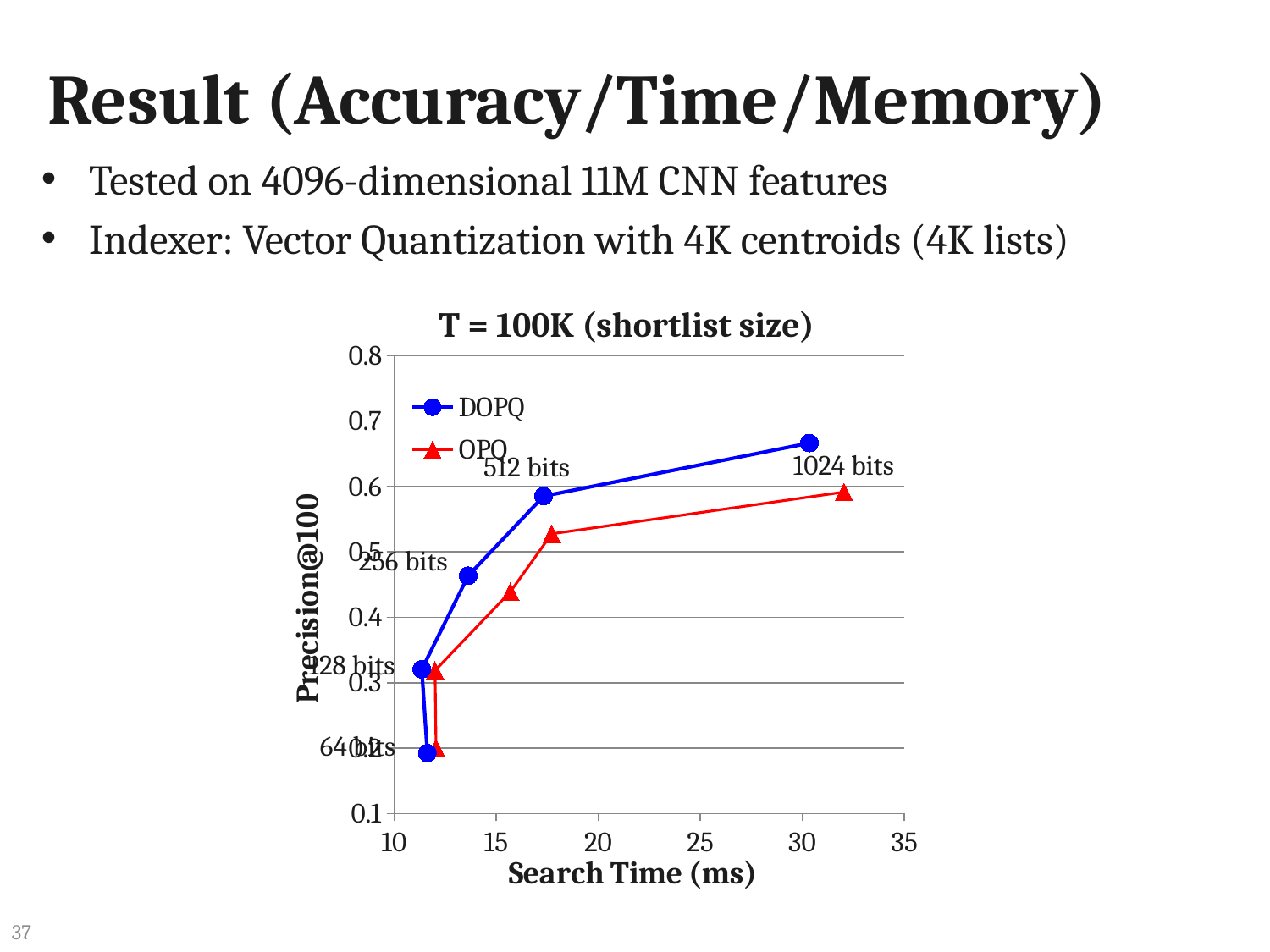
Is the Precision@100 value for DOPQ at 64 bits greater or less than 0.3? less At 1024 bits, which series has the higher Precision@100, DOPQ or OPQ? DOPQ Is the search time for DOPQ at 1024 bits greater or less than 25 ms? greater What kind of chart is shown on the slide? line chart Is the Precision@100 value for DOPQ at 1024 bits greater or less than 0.6? greater What is the title of the chart? T = 100K (shortlist size) How many data points are plotted for the DOPQ series? 5 Does Precision@100 rise or fall as search time increases for the DOPQ series? rise How many series does the legend list? 2 What are the two series named in the legend? DOPQ and OPQ